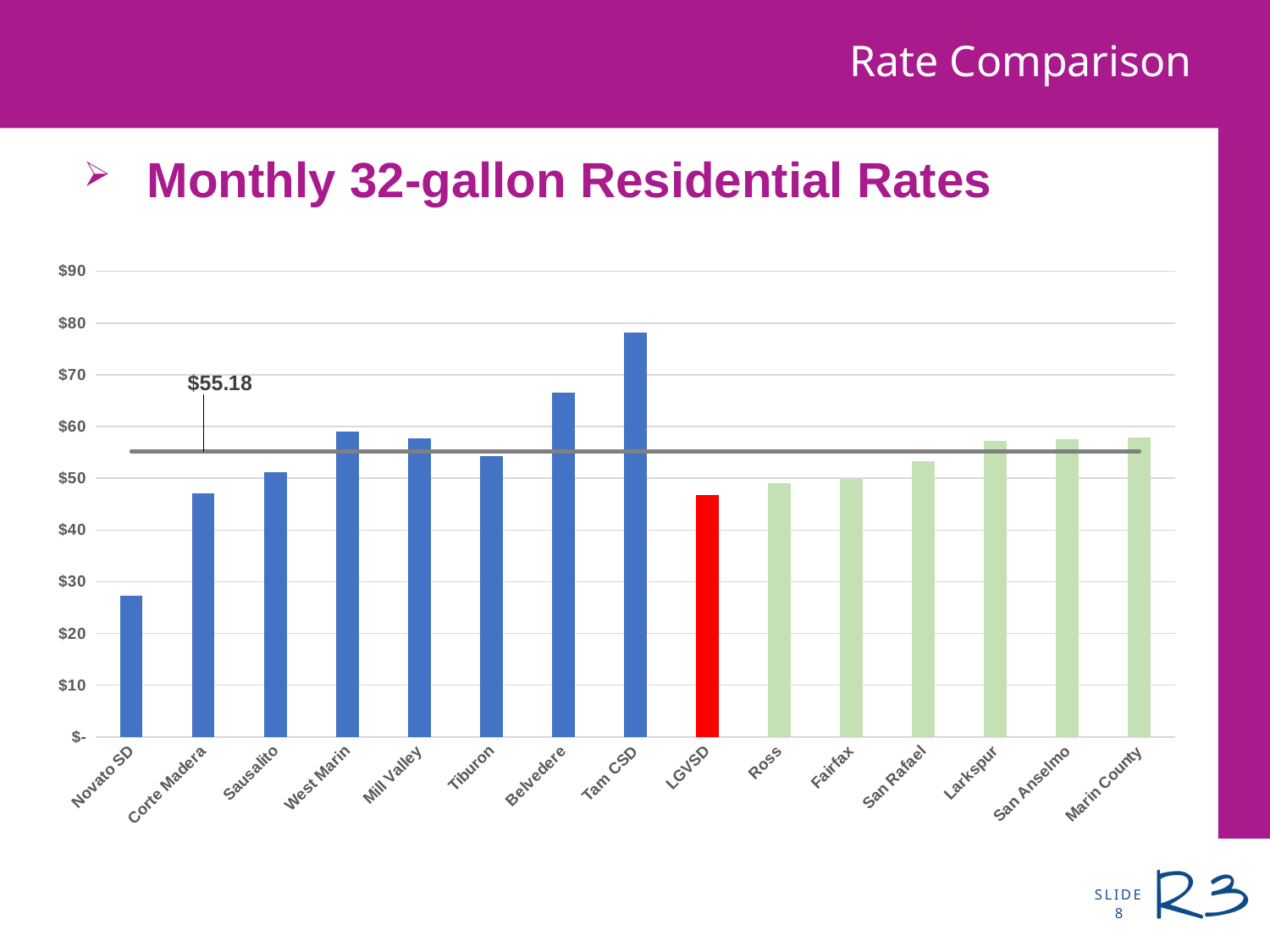
Is the value for LGVSD greater or less than $50? less Which category has the highest monthly 32-gallon residential rate? Tam CSD Is the value for Novato SD greater or less than $30? less What kind of chart is shown on the slide? bar chart How many categories (agencies) are shown on the x axis of the chart? 15 Which category's bar is colored red in the chart? LGVSD What value is the horizontal reference line in the chart labeled with? $55.18 Which category has the lowest monthly 32-gallon residential rate? Novato SD Which has a higher rate, Novato SD or Corte Madera? Corte Madera Is the value for Tam CSD greater or less than $70? greater Which has a higher rate, Belvedere or Mill Valley? Belvedere